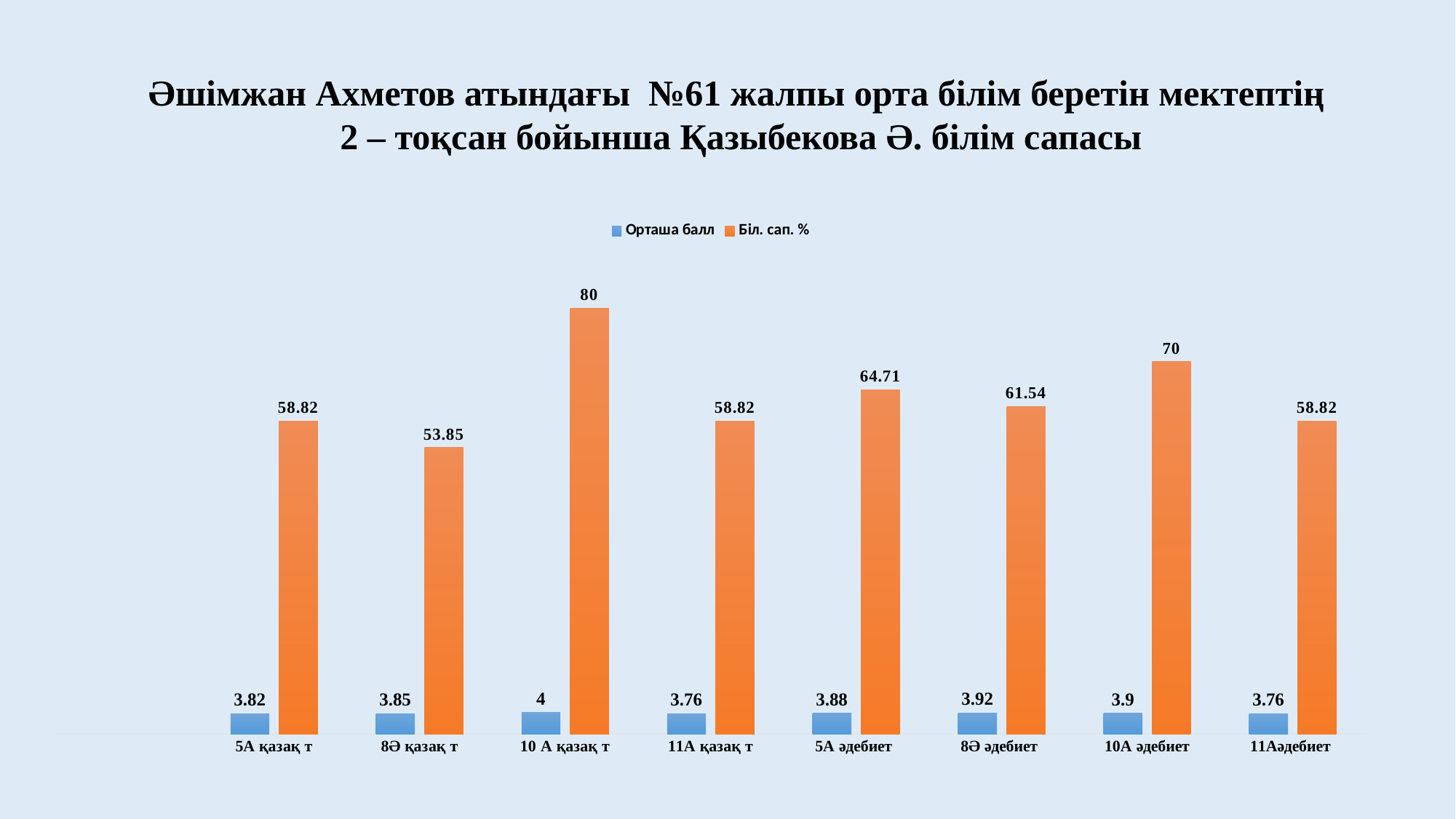
How many categories are shown on the x axis? 8 Which is larger, the Біл. сап. % value for 8Ә әдебиет or for 8Ә қазақ т? 8Ә әдебиет What kind of chart is shown on the slide? Bar chart Which category has the lowest Біл. сап. % value? 8Ә қазақ т What is the Орташа балл value for 11А қазақ т? 3.76 Which category has the highest Біл. сап. % value? 10 А қазақ т What is the Орташа балл value for 8Ә әдебиет? 3.92 What is the Біл. сап. % value for 10 А қазақ т? 80 What is the difference between the Біл. сап. % values for 10 А қазақ т and 10А әдебиет? 10 What is the Біл. сап. % value for 5А әдебиет? 64.71 Which category has the highest Орташа балл value? 10 А қазақ т How many series does the legend list? 2